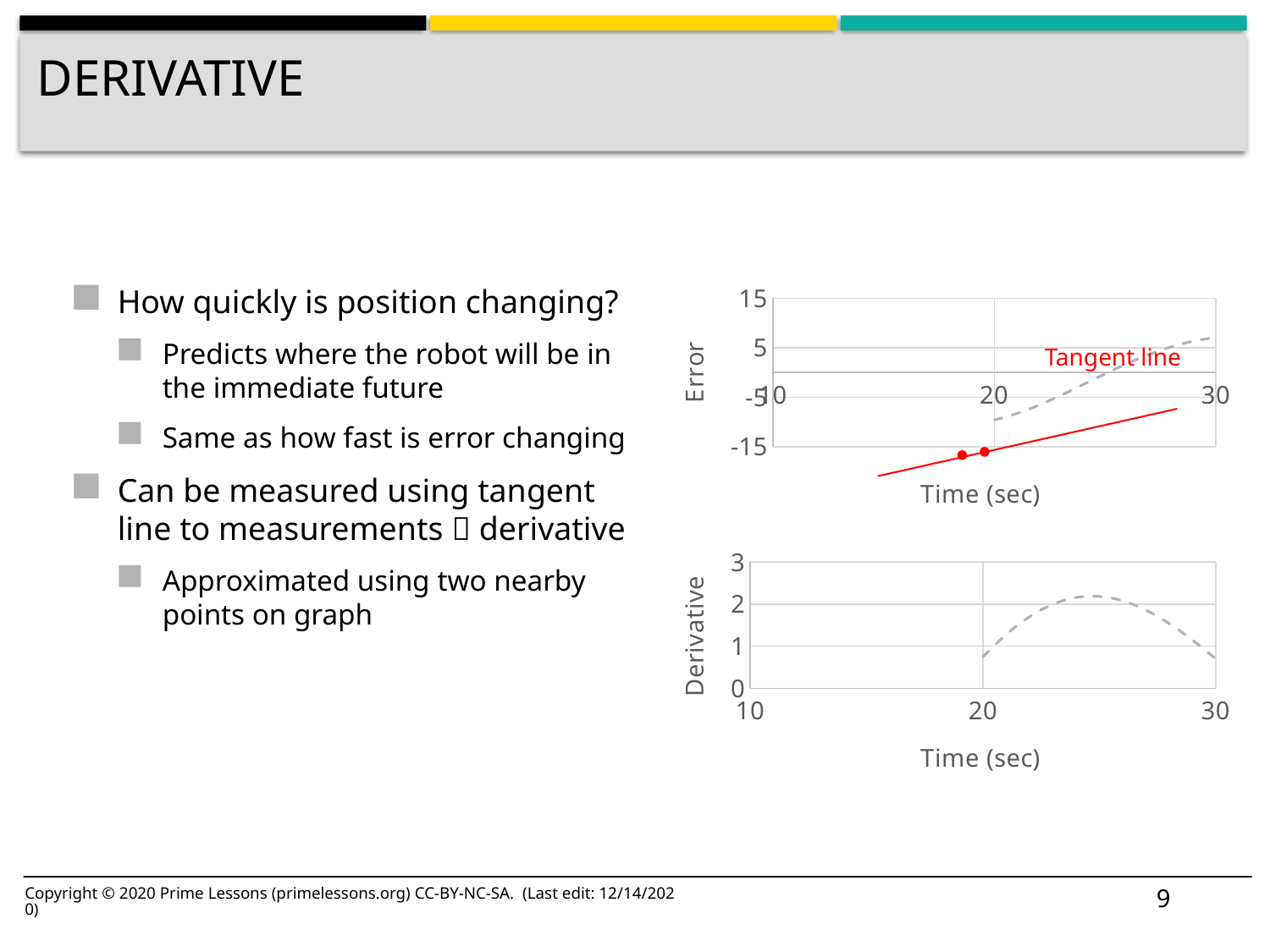
What text label is written next to the red line in the top chart? Tangent line In the top chart, does the dashed Error line rise or fall as time increases from 20 to 30 seconds? rises In the bottom chart, does the Derivative curve rise or fall between 25 and 30 seconds? falls In the bottom chart, is the Derivative value at 20 seconds greater or less than 2? less In the top chart, is the Error value at 20 seconds greater or less than 0? less What kind of chart is the bottom chart (Derivative vs Time)? line chart What kind of chart is the top chart (Error vs Time)? line chart What is the y-axis label of the top chart? Error In the top chart, how many red points are marked on the tangent line? 2 In the bottom chart, is the peak Derivative value greater or less than 3? less